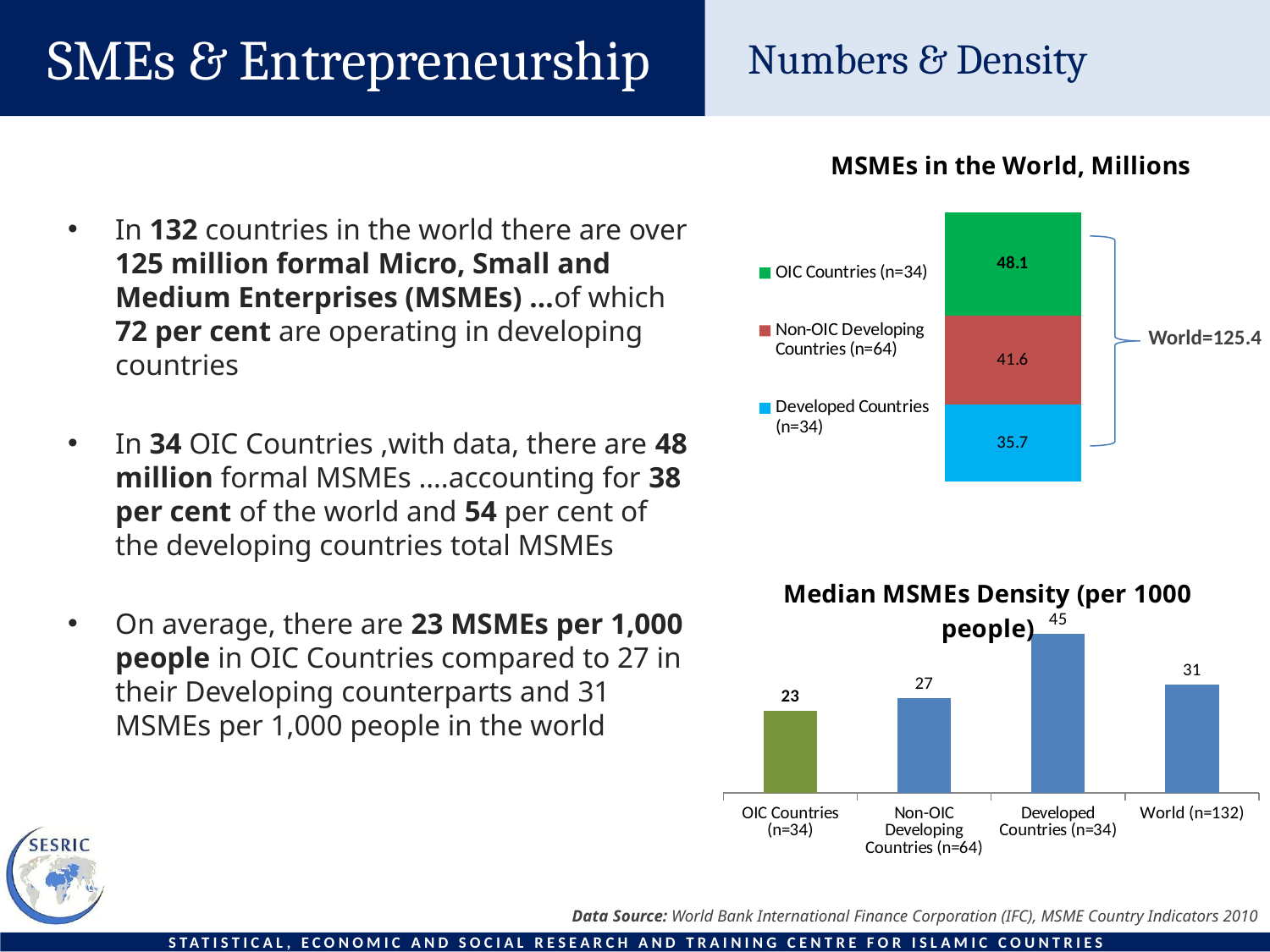
In the 'Median MSMEs Density (per 1000 people)' chart, how many categories are shown? 4 In the 'MSMEs in the World, Millions' chart, how many series does the legend list? 3 In the 'MSMEs in the World, Millions' chart, what is the value for Developed Countries (n=34)? 35.7 In the 'MSMEs in the World, Millions' chart, what is the value for OIC Countries (n=34)? 48.1 In the 'Median MSMEs Density (per 1000 people)' chart, what is the value for Non-OIC Developing Countries (n=64)? 27 In the 'Median MSMEs Density (per 1000 people)' chart, what is the difference between the World (n=132) and OIC Countries (n=34) values? 8 What kind of chart is the 'Median MSMEs Density (per 1000 people)' chart? Bar chart In the 'MSMEs in the World, Millions' chart, what is the difference between the Non-OIC Developing Countries (n=64) and Developed Countries (n=34) values? 5.9 In the 'MSMEs in the World, Millions' chart, which segment is the largest? OIC Countries (n=34) In the 'Median MSMEs Density (per 1000 people)' chart, which category has the highest value? Developed Countries (n=34) In the 'Median MSMEs Density (per 1000 people)' chart, which category has the lowest value? OIC Countries (n=34) In the 'MSMEs in the World, Millions' chart, what is the total of the stacked bar? 125.4